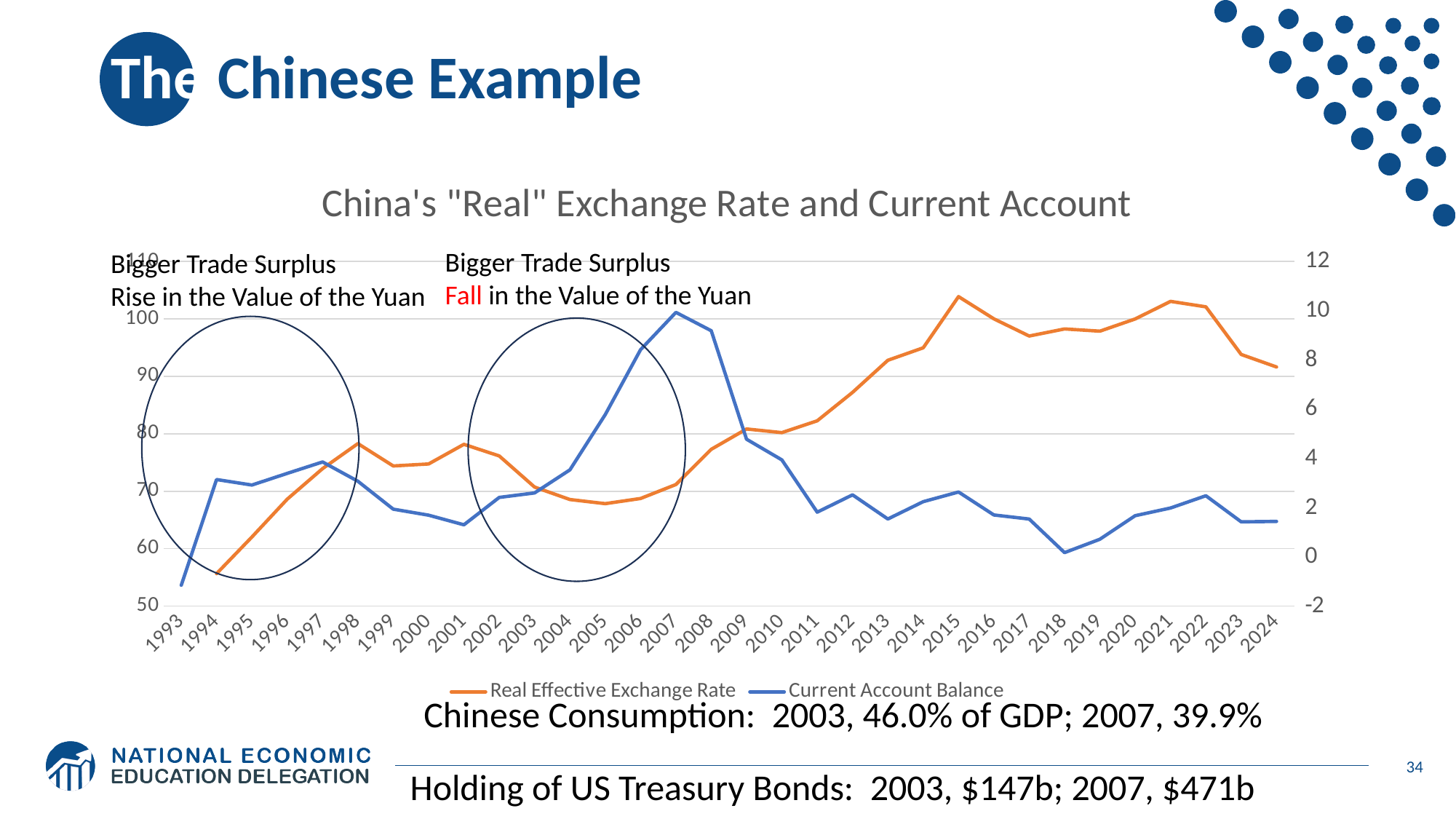
What is the title of the chart? China's "Real" Exchange Rate and Current Account Is the Real Effective Exchange Rate in 2015 greater or less than 100? greater Which series is drawn in orange? Real Effective Exchange Rate How many years are shown on the x axis of the chart? 32 Is the Current Account Balance in 2007 greater or less than 8? greater In which year is the Current Account Balance at its lowest? 1993 How many series does the chart legend list? 2 Does the Real Effective Exchange Rate rise or fall between 2008 and 2015? rise Is the Current Account Balance in 2018 greater or less than 2? less What kind of chart is shown on the slide? line chart In which year does the Real Effective Exchange Rate reach its highest value? 2015 In which year does the Current Account Balance reach its highest value? 2007